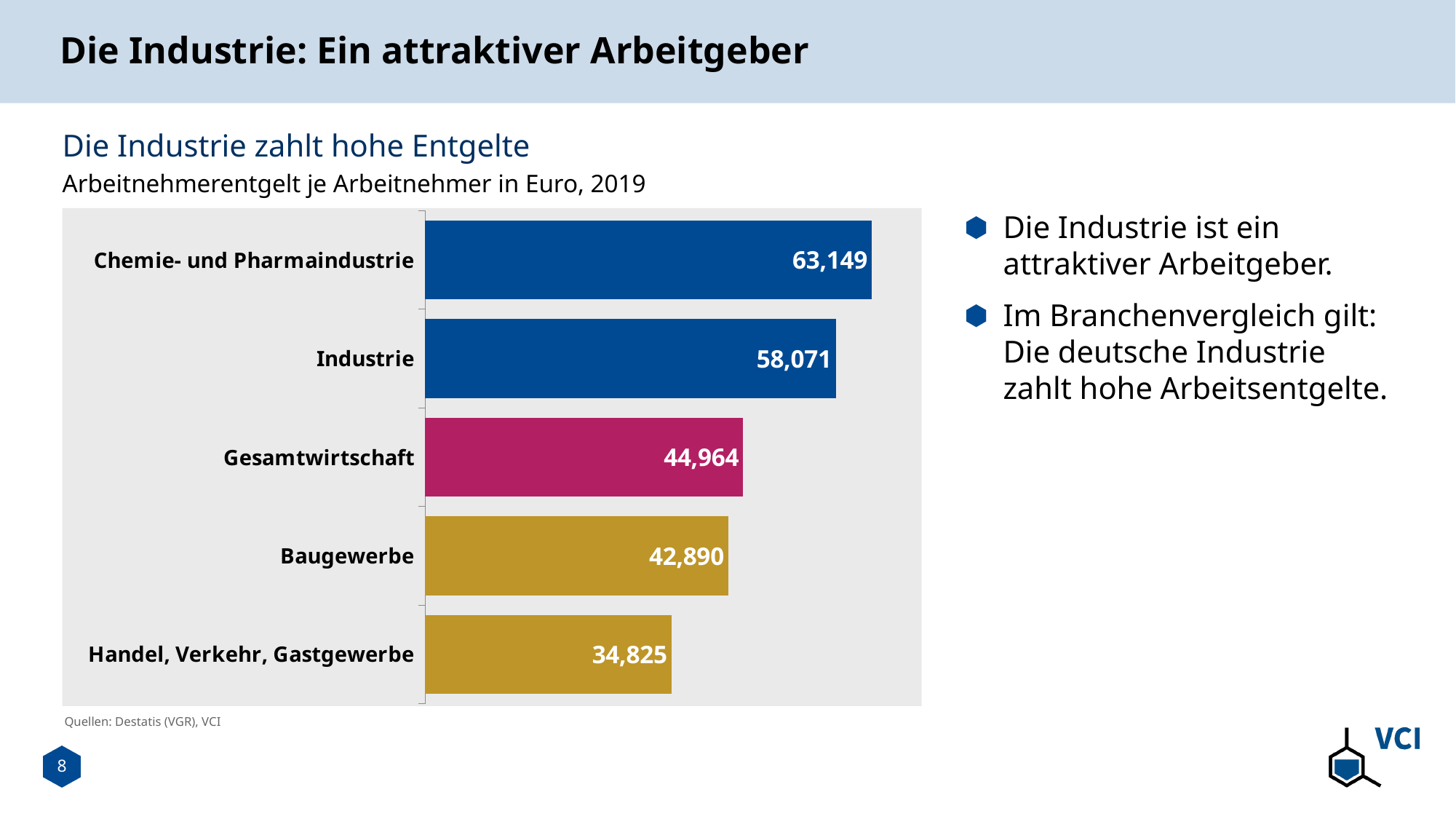
Which category has the lowest value? Handel, Verkehr, Gastgewerbe How many categories are shown in the chart? 5 What is the difference between the values for Gesamtwirtschaft and Baugewerbe? 2,074 What value is shown for Gesamtwirtschaft? 44,964 What is the difference between the values for Chemie- und Pharmaindustrie and Industrie? 5,078 What is the subtitle describing the chart's unit and year? Arbeitnehmerentgelt je Arbeitnehmer in Euro, 2019 What value is shown for Handel, Verkehr, Gastgewerbe? 34,825 What kind of chart is shown on the slide? Bar chart Which is larger, the value for Baugewerbe or the value for Gesamtwirtschaft? Gesamtwirtschaft What value is shown for Industrie? 58,071 Which category has the highest value? Chemie- und Pharmaindustrie What is the Arbeitnehmerentgelt je Arbeitnehmer for Chemie- und Pharmaindustrie? 63,149